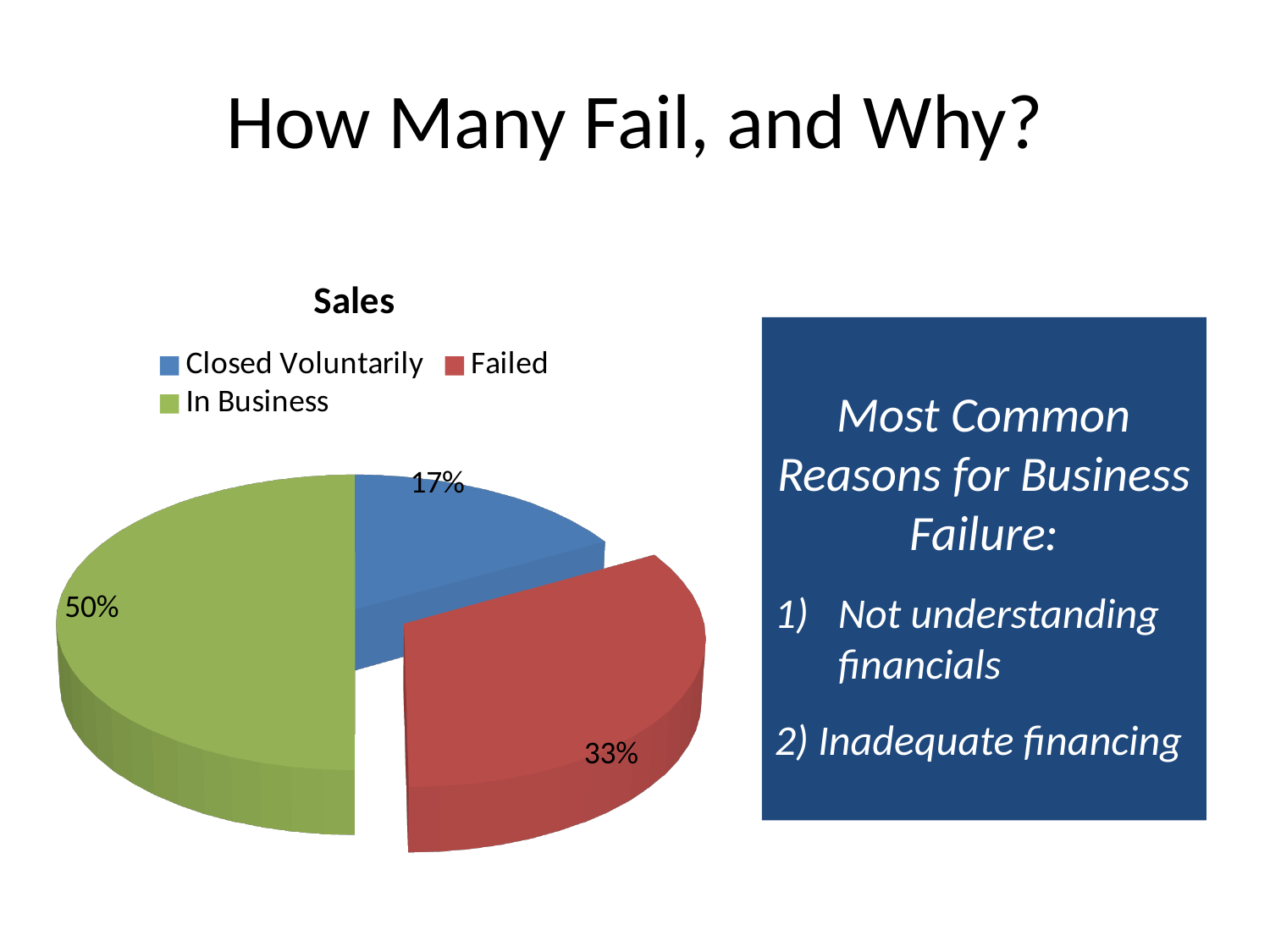
What is the difference in percentage points between the In Business slice and the Failed slice? 17% Which category has the smallest slice of the pie? Closed Voluntarily What colour is the In Business slice? green What share of the pie does the In Business slice represent? 50% How many entries does the legend list? 3 What share of the pie does the Closed Voluntarily slice represent? 17% What share of the pie does the Failed slice represent? 33% What is the title of the chart? Sales How many slices does the pie chart have? 3 Which category has the largest slice of the pie? In Business What kind of chart is shown on the slide? pie chart Which is larger, the Failed slice or the Closed Voluntarily slice? Failed